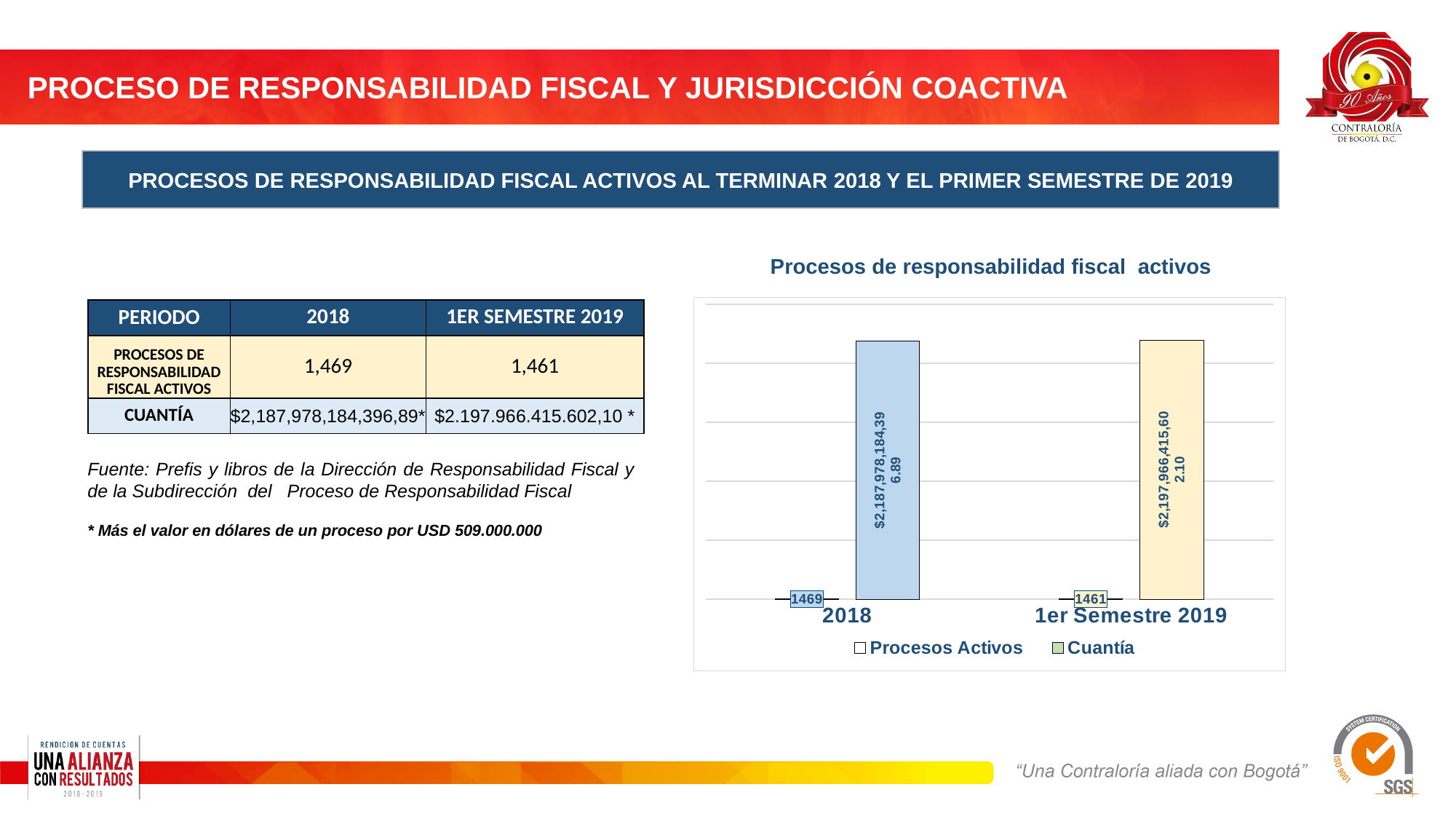
What is the Cuantía value labelled on the 1er Semestre 2019 bar in the chart? $2,197,966,415,602.10 What is the Cuantía value labelled on the 2018 bar in the chart? $2,187,978,184,396.89 By how much did Procesos Activos change between 2018 and 1er Semestre 2019 according to the chart? 8 What is the title of the chart? Procesos de responsabilidad fiscal activos How many series does the chart's legend list? 2 What is the value of Procesos Activos for 1er Semestre 2019 in the chart? 1461 What kind of chart is shown on the slide? bar chart How many categories are shown on the x axis of the chart? 2 What is the value of Procesos Activos for 2018 in the chart? 1469 Which period has the higher number of Procesos Activos in the chart? 2018 Do the Procesos Activos values rise or fall from 2018 to 1er Semestre 2019? fall Which period has the larger Cuantía value in the chart, 2018 or 1er Semestre 2019? 1er Semestre 2019